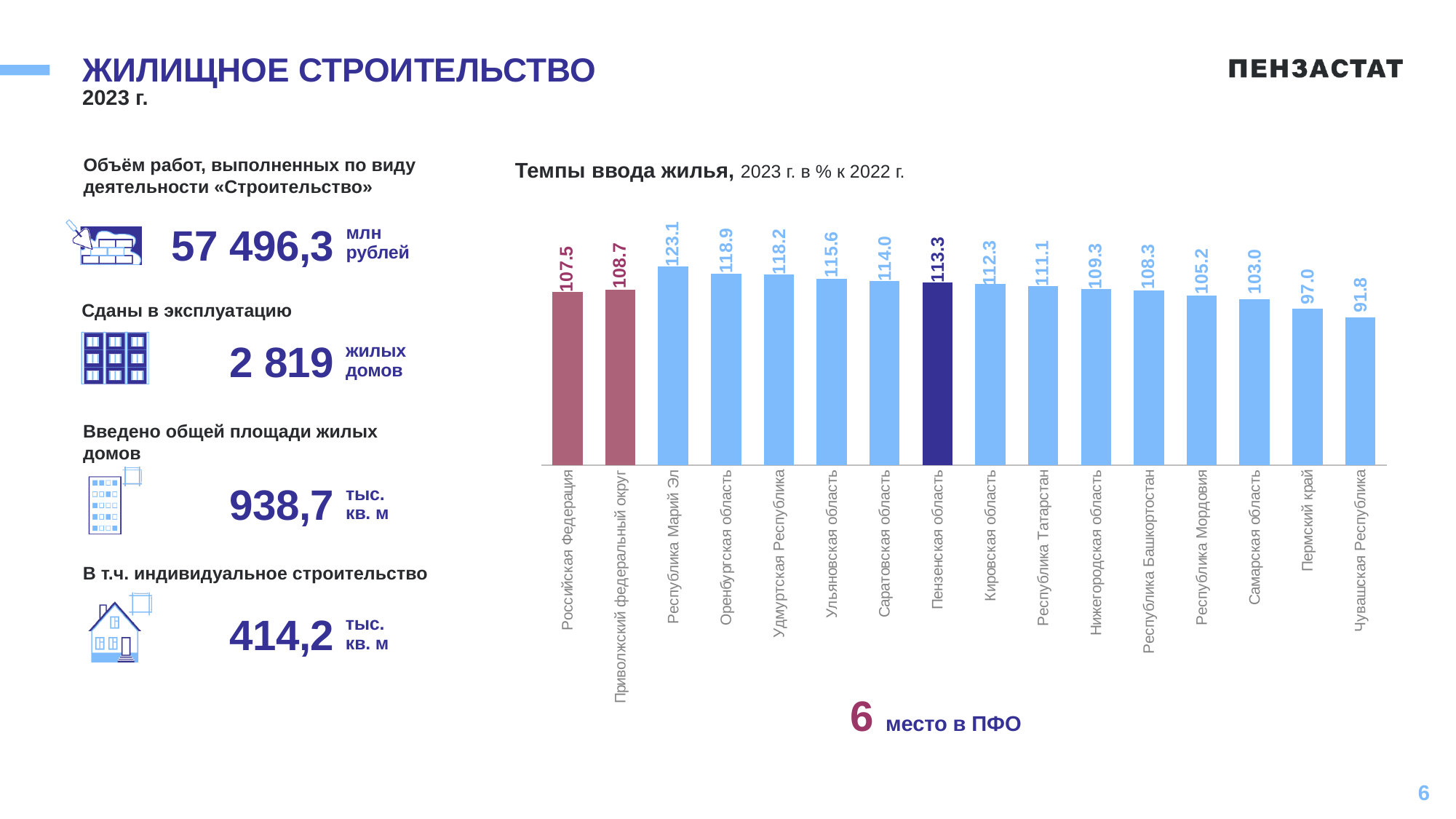
What is the value for Пензенская область in the chart 'Темпы ввода жилья'? 113.3 What is the difference between the values for Пензенская область and Российская Федерация? 5.8 What kind of chart is 'Темпы ввода жилья'? Bar chart What is the value for Приволжский федеральный округ in the chart? 108.7 What is the difference between the values for Республика Марий Эл and Чувашская Республика? 31.3 What is the value for Российская Федерация in the chart? 107.5 What is the title of the chart on the slide? Темпы ввода жилья, 2023 г. в % к 2022 г. Which region has the lowest value in the chart? Чувашская Республика How many bars are shown in the chart 'Темпы ввода жилья'? 16 Which is larger: the value for Оренбургская область or the value for Удмуртская Республика? Оренбургская область Which region has the highest value in the chart 'Темпы ввода жилья'? Республика Марий Эл From Республика Марий Эл to Чувашская Республика, do the values rise or fall along the x axis? Fall